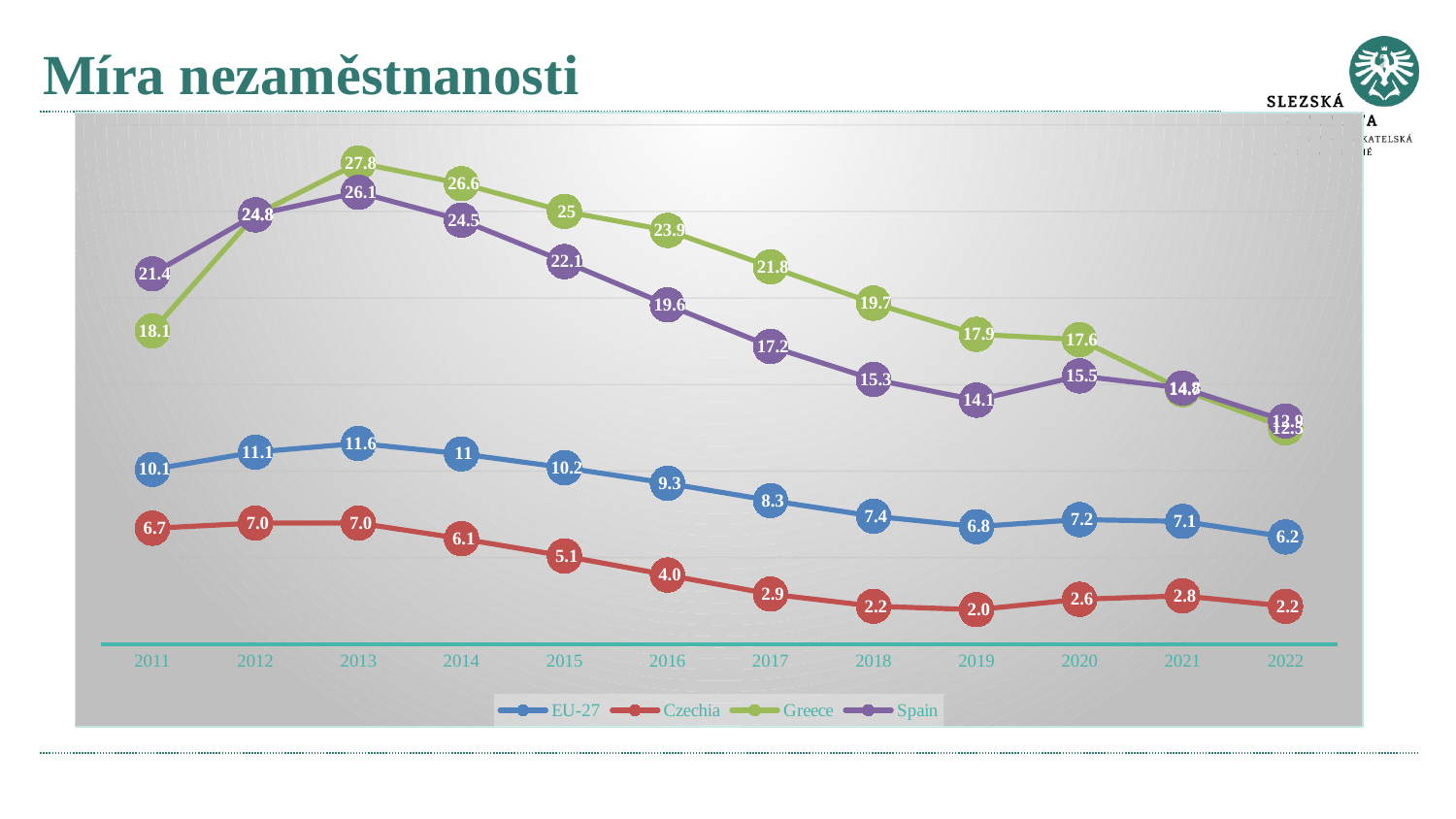
Does the Czechia line rise or fall from 2013 to 2019? fall What is the value for Spain in 2018? 15.3 What is the value for Czechia in 2019? 2.0 What is the value for Greece in 2013? 27.8 In which year does Greece reach its highest value? 2013 How many series does the legend list? 4 In which year does Czechia have its lowest value? 2019 How many years are shown on the x axis? 12 What is the title of the slide? Míra nezaměstnanosti In 2011, which is higher, Spain or Greece? Spain What is the difference between the EU-27 value in 2011 and in 2022? 3.9 What kind of chart is shown on the slide? line chart